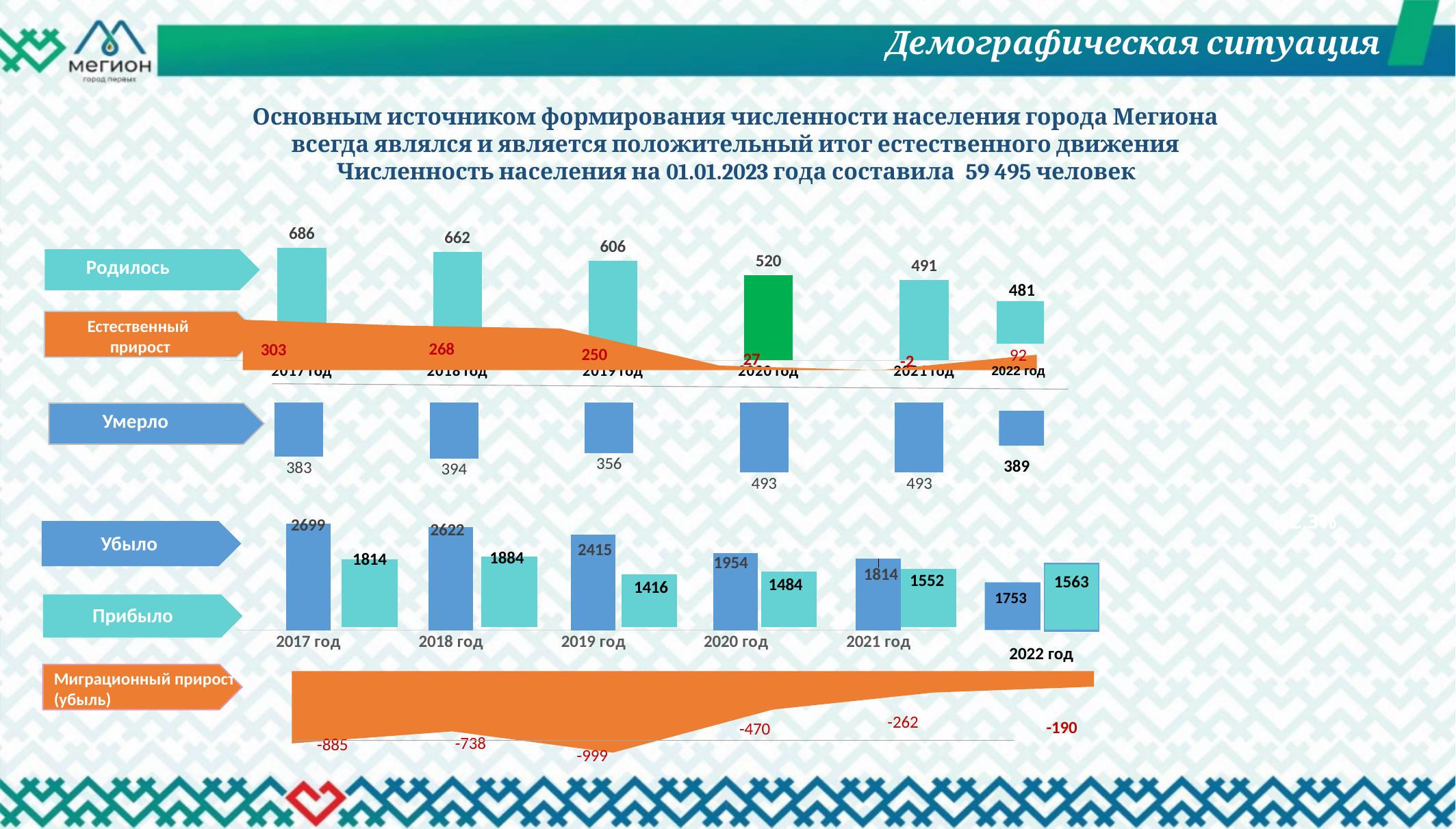
In the lower chart, what is the Убыло value for 2018 год? 2622 In the upper chart, which year has the highest Родилось value? 2017 год In the upper chart, what is the Естественный прирост value for 2021 год? -2 In the upper chart, what is the difference between Родилось and Умерло in 2019 год? 250 In the upper chart, what is the value for Умерло in 2020 год? 493 In the upper chart, does the Родилось value rise or fall from 2017 год to 2022 год? fall In the lower chart, which is larger in 2021 год, Убыло or Прибыло? Убыло How many years are shown on the x axis of the lower chart? 6 In the lower chart, which year has the lowest Миграционный прирост (убыль) value? 2019 год In the lower chart, what is the Прибыло value for 2022 год? 1563 In the upper chart, what is the value for Родилось in 2017 год? 686 In the upper chart, which year has the lowest Умерло value? 2019 год